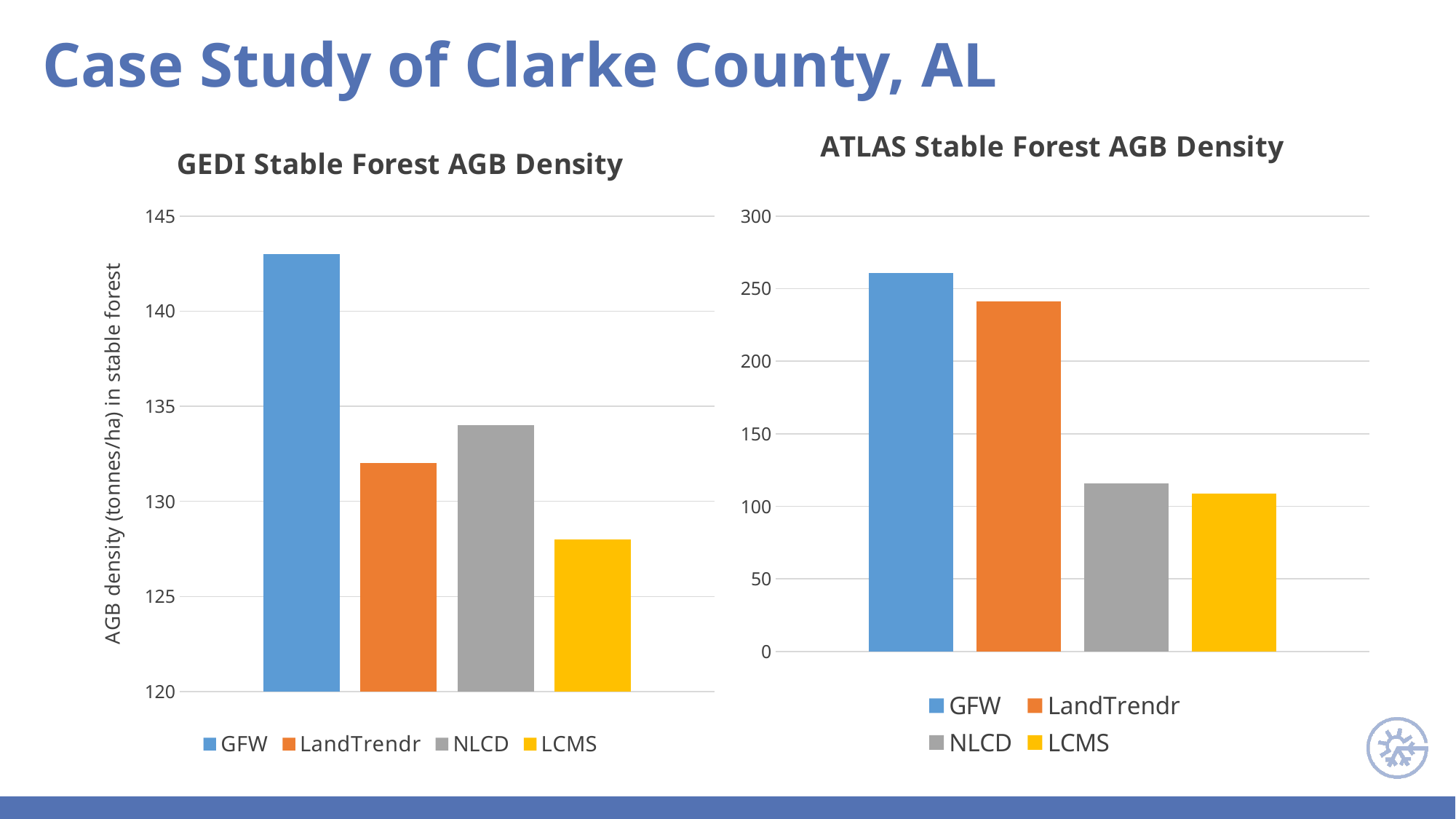
On the GEDI Stable Forest AGB Density chart, is the value for GFW greater or less than 140? greater What kind of chart is the ATLAS Stable Forest AGB Density chart? bar chart On the ATLAS Stable Forest AGB Density chart, which series has the highest AGB density? GFW On the ATLAS Stable Forest AGB Density chart, which is larger, the value for LandTrendr or the value for NLCD? LandTrendr On the GEDI Stable Forest AGB Density chart, which series has the lowest AGB density? LCMS On the ATLAS Stable Forest AGB Density chart, is the value for GFW greater or less than 250? greater How many series does the legend of the GEDI Stable Forest AGB Density chart list? 4 On the ATLAS Stable Forest AGB Density chart, is the value for NLCD greater or less than 100? greater On the GEDI Stable Forest AGB Density chart, which series has the highest AGB density? GFW